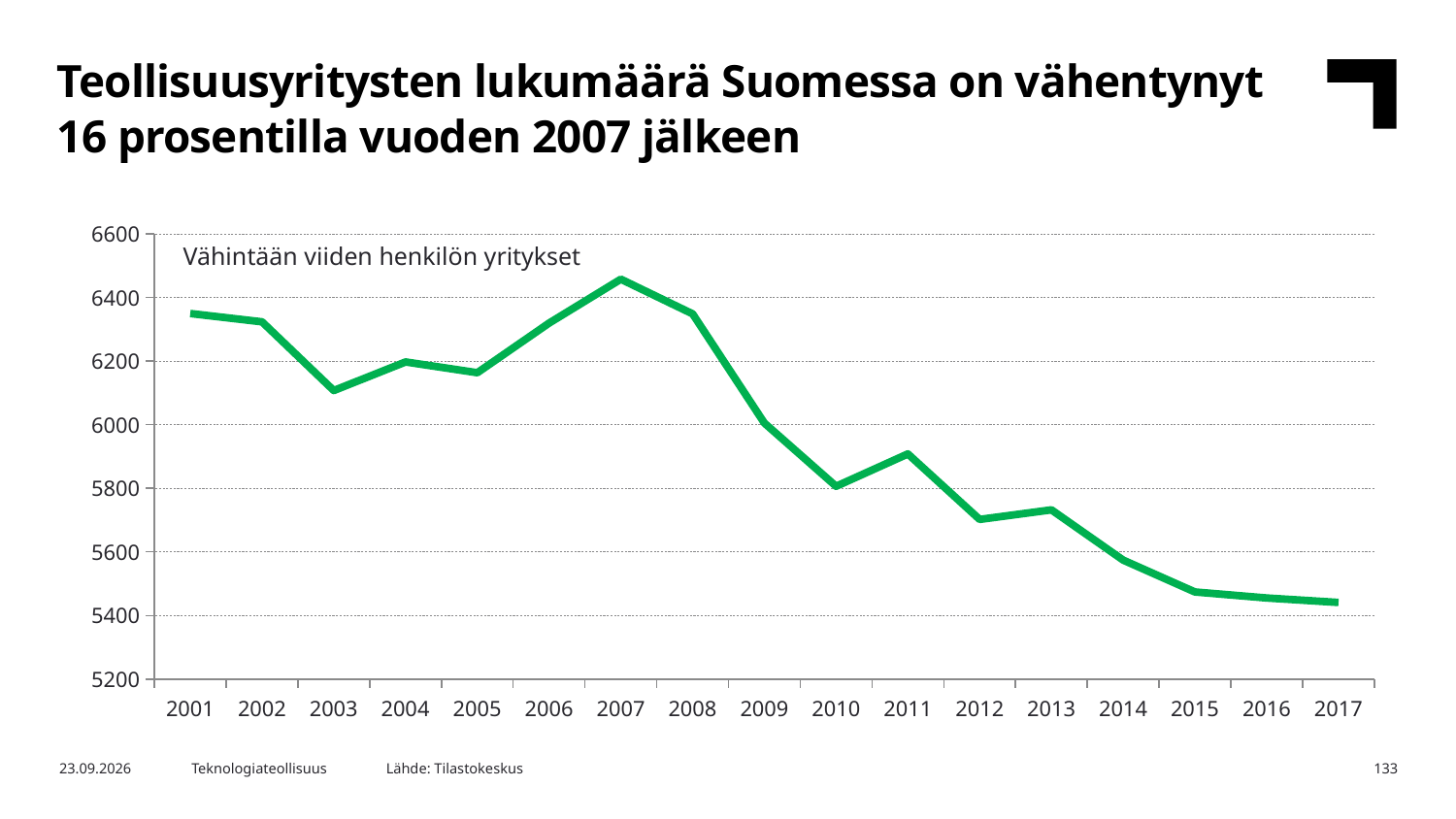
Is the value for 2007 greater or less than 6400? greater In which year does the line reach its highest value? 2007 Does the number of companies rise or fall overall from 2007 to 2017? fall Is the value for 2011 greater or less than 5800? greater Which year has the larger value, 2010 or 2011? 2011 What kind of chart is shown on the slide? line chart Is the value for 2001 greater or less than 6200? greater What label is shown inside the chart describing the plotted series? Vähintään viiden henkilön yritykset How many years are plotted on the x axis of the chart? 17